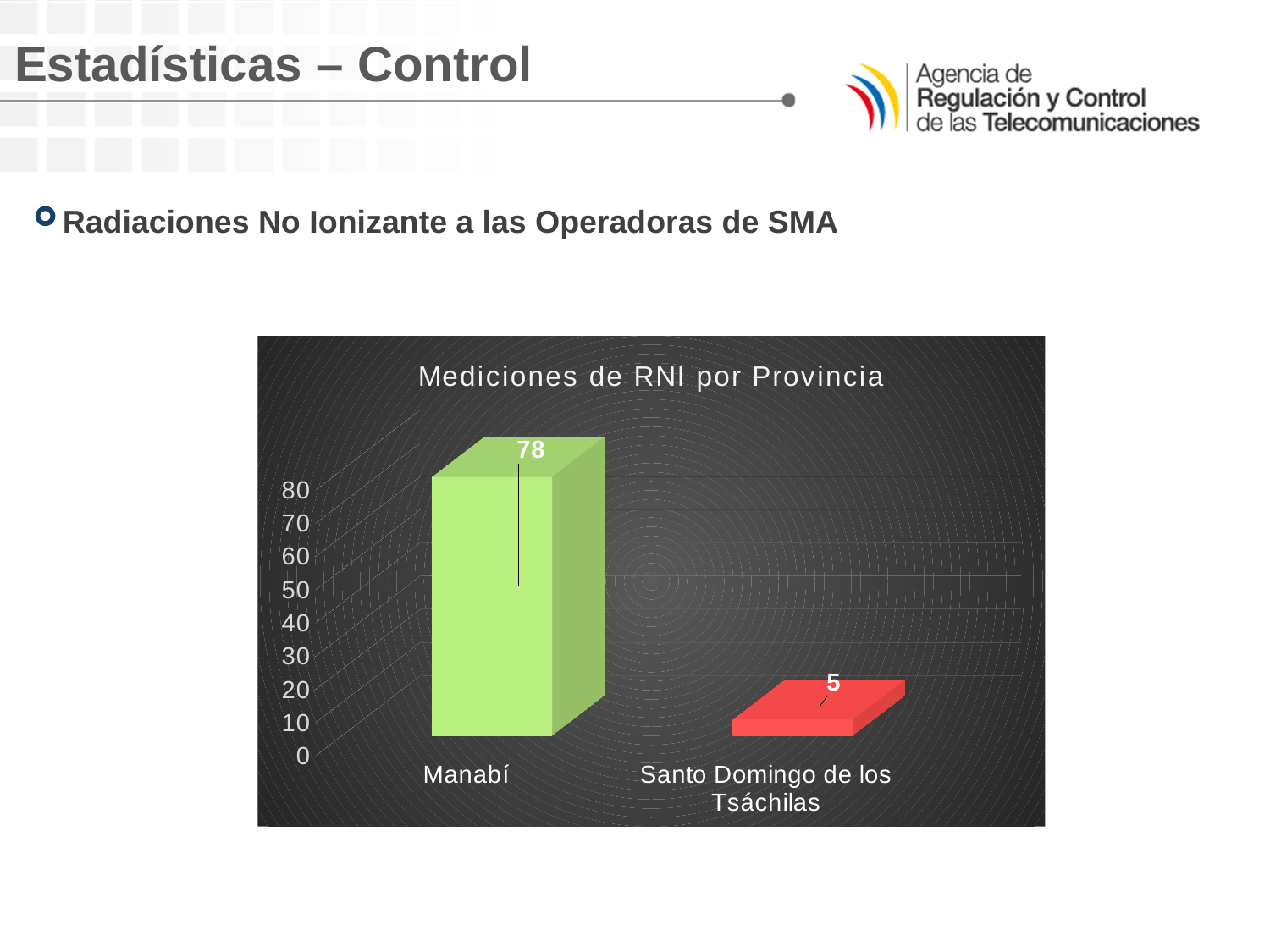
What is the title of the chart? Mediciones de RNI por Provincia How many provinces are shown in the chart? 2 Is the value for Santo Domingo de los Tsáchilas greater or less than 10? less What is the value for Santo Domingo de los Tsáchilas in the chart? 5 What colour is the bar for Manabí? Green What kind of chart is shown on the slide? Bar chart Which is larger, the value for Manabí or the value for Santo Domingo de los Tsáchilas? Manabí Which province has the highest value in the chart? Manabí Is the value for Manabí greater or less than 50? greater What is the difference between the values for Manabí and Santo Domingo de los Tsáchilas? 73 Which province has the lowest value in the chart? Santo Domingo de los Tsáchilas What is the value for Manabí in the chart? 78